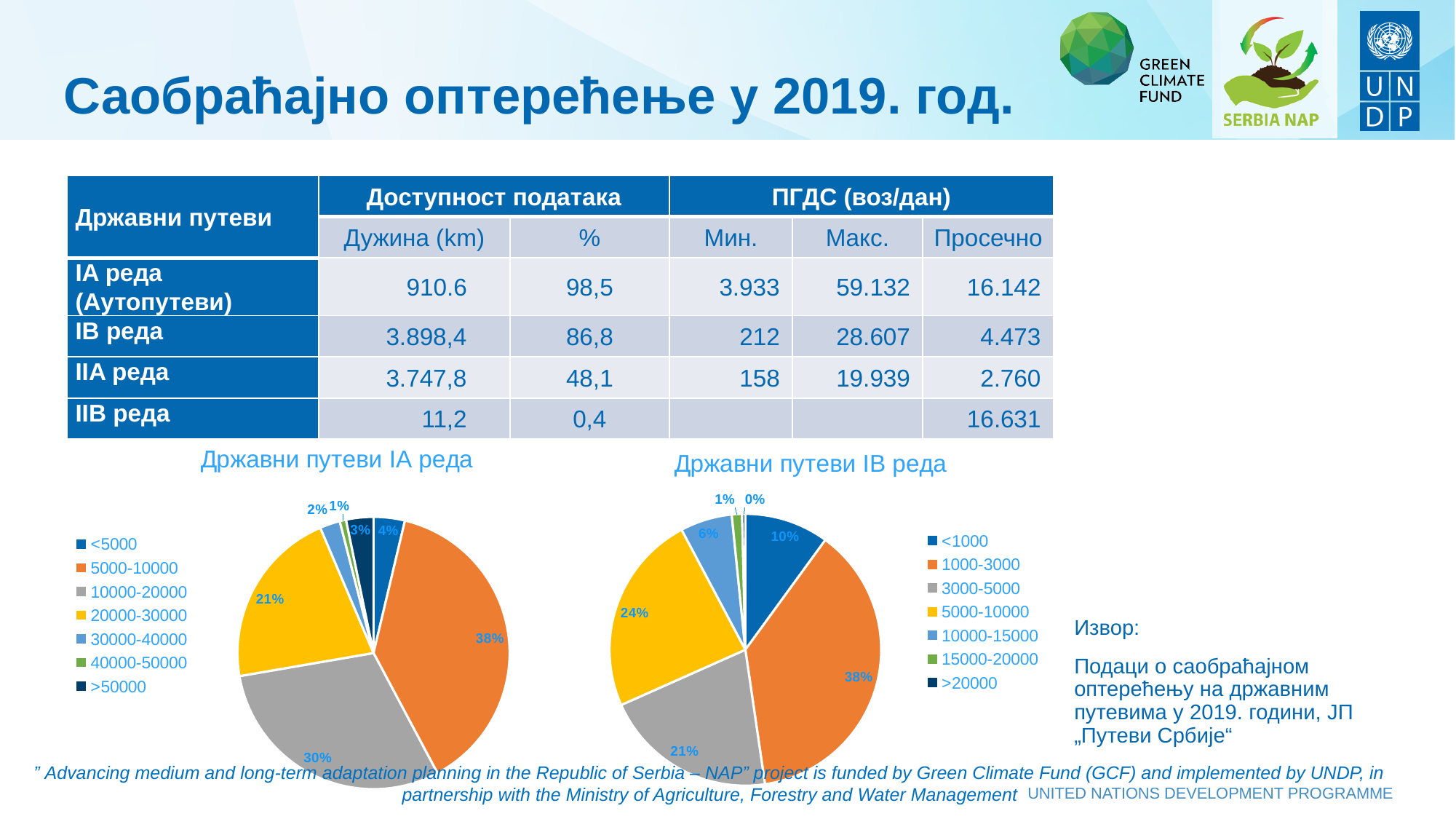
In the pie chart titled "Државни путеви IA реда", how many categories does the legend list? 7 In the pie chart titled "Државни путеви IB реда", which category has the largest share? 1000-3000 In the pie chart titled "Државни путеви IA реда", what share does the 10000-20000 category have? 30% In the pie chart titled "Државни путеви IA реда", what is the share of the >50000 category? 3% In the pie chart titled "Државни путеви IB реда", what share does the <1000 category have? 10% In the pie chart titled "Државни путеви IA реда", which category has the largest share? 5000-10000 In the pie chart titled "Државни путеви IB реда", which has the larger share, 5000-10000 or 10000-15000? 5000-10000 What type of chart is used for "Државни путеви IA реда"? Pie chart In the pie chart titled "Државни путеви IB реда", what colour represents the 1000-3000 category? Orange In the pie chart titled "Државни путеви IB реда", what is the difference in share between the 1000-3000 and 3000-5000 categories? 17%